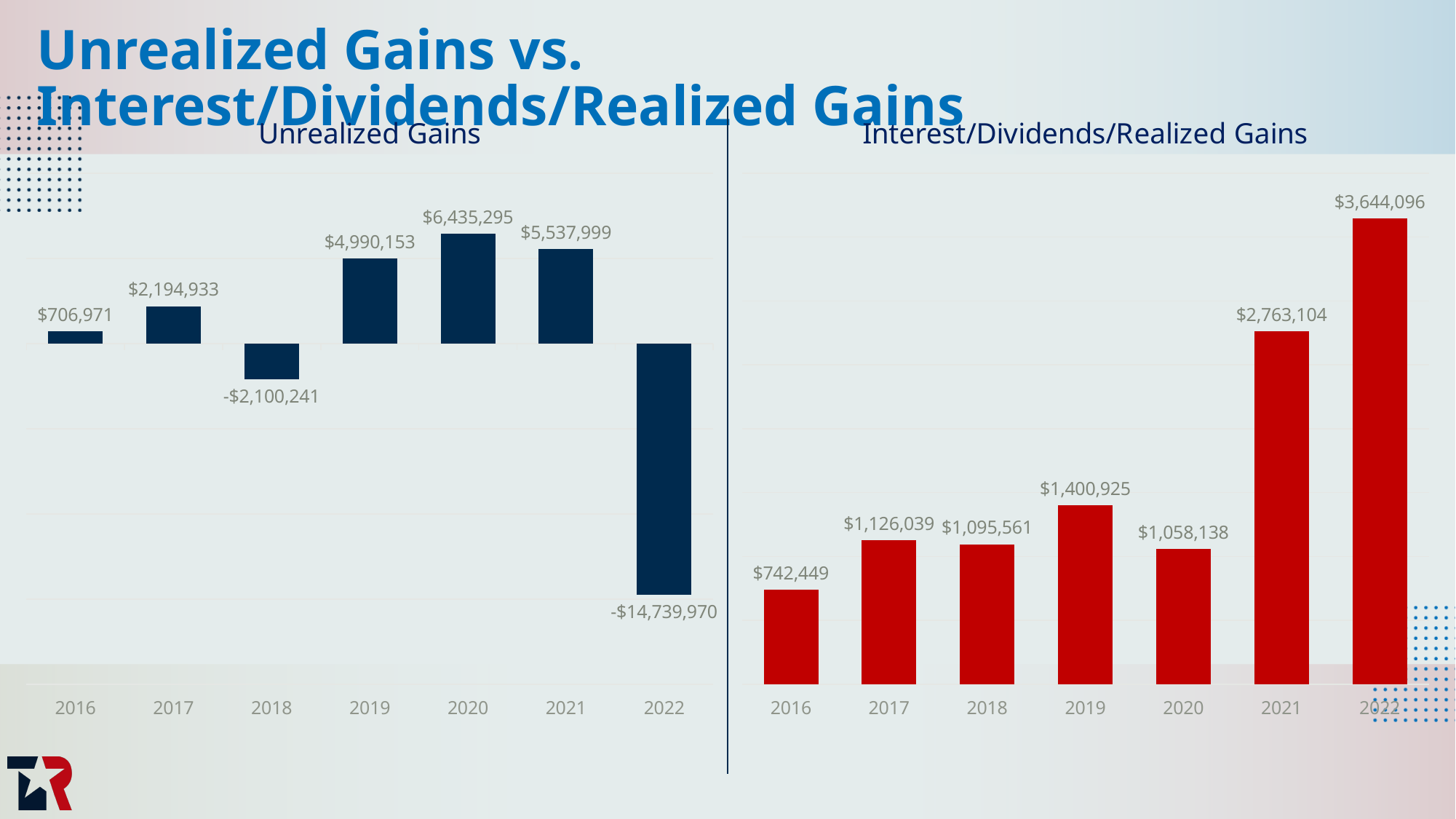
In the Unrealized Gains chart, what is the value for 2018? -$2,100,241 In the Interest/Dividends/Realized Gains chart, what is the value for 2016? $742,449 In the Interest/Dividends/Realized Gains chart, what is the value for 2019? $1,400,925 In the Interest/Dividends/Realized Gains chart, which year has the highest value? 2022 In the Interest/Dividends/Realized Gains chart, what is the difference between the 2022 and 2021 values? $880,992 What type of chart is the Unrealized Gains chart? Bar chart In the Unrealized Gains chart, which year has the lowest value? 2022 How many years are shown in the Interest/Dividends/Realized Gains chart? 7 In the Unrealized Gains chart, what is the value for 2020? $6,435,295 In the Unrealized Gains chart, which is larger, the value for 2019 or the value for 2021? 2021 In the Unrealized Gains chart, which year has the highest value? 2020 In the Interest/Dividends/Realized Gains chart, which year has the lowest value? 2016